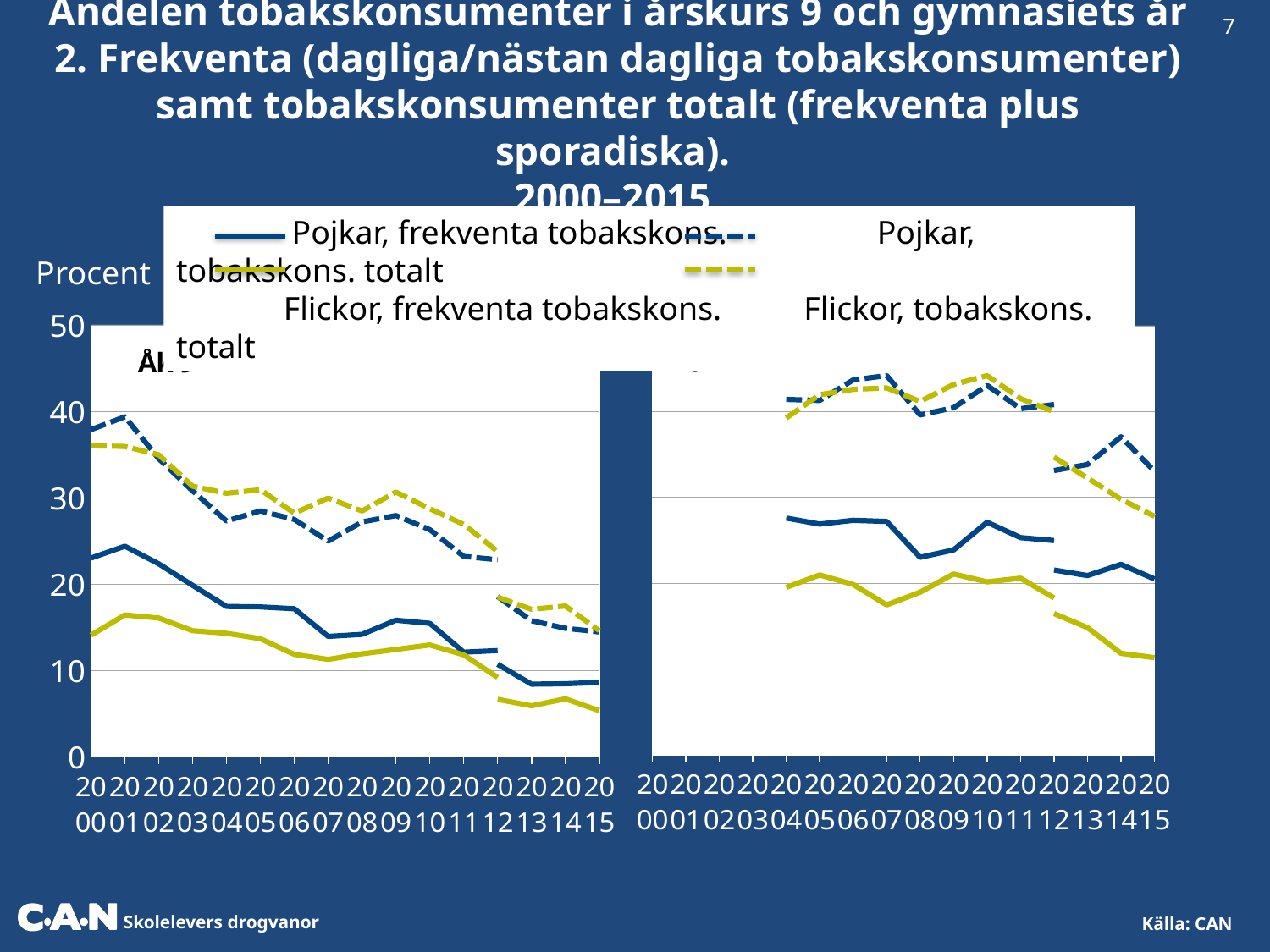
In the left panel, does the solid line for Pojkar, frekventa tobakskons. rise or fall from 2000 to 2015? fall In the right panel, is the value for Flickor, frekventa tobakskons. in 2015 greater or less than 20? less What kind of chart is shown on the slide? line chart In the right panel, is the value for Flickor, tobakskons. totalt in 2009 greater or less than 40? greater How many years are shown on the x axis of each panel? 16 What is the label on the y axis of the chart? Procent In the left panel, is the value for Pojkar, tobakskons. totalt in 2001 greater or less than 30? greater How many series does the legend list? 4 In the left panel in 2000, which is larger: Pojkar, frekventa tobakskons. or Flickor, frekventa tobakskons.? Pojkar, frekventa tobakskons. What source is cited at the bottom right of the slide? Källa: CAN